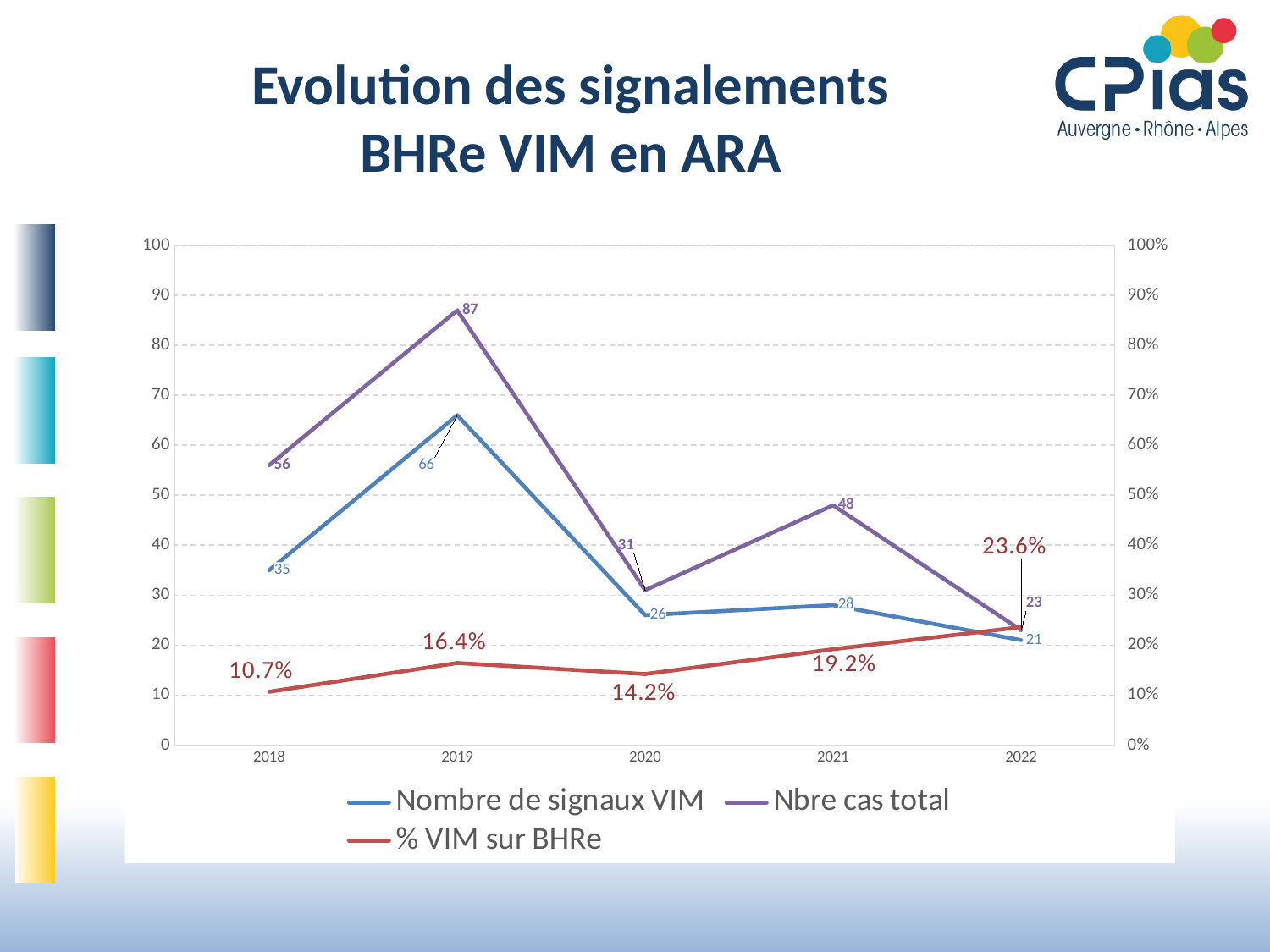
Which is larger in 2021: Nbre cas total or Nombre de signaux VIM? Nbre cas total What is the value of Nombre de signaux VIM in 2018? 35 In which year is Nombre de signaux VIM lowest? 2022 What is the % VIM sur BHRe value in 2022? 23.6% How many series does the legend list? 3 What is the difference between Nbre cas total and Nombre de signaux VIM in 2019? 21 What type of chart is shown on the slide? line chart What is the value of Nbre cas total in 2019? 87 How many years are plotted on the x axis? 5 Does the % VIM sur BHRe series rise or fall between 2020 and 2022? rise In which year is Nbre cas total highest? 2019 What is the title of the chart on the slide? Evolution des signalements BHRe VIM en ARA